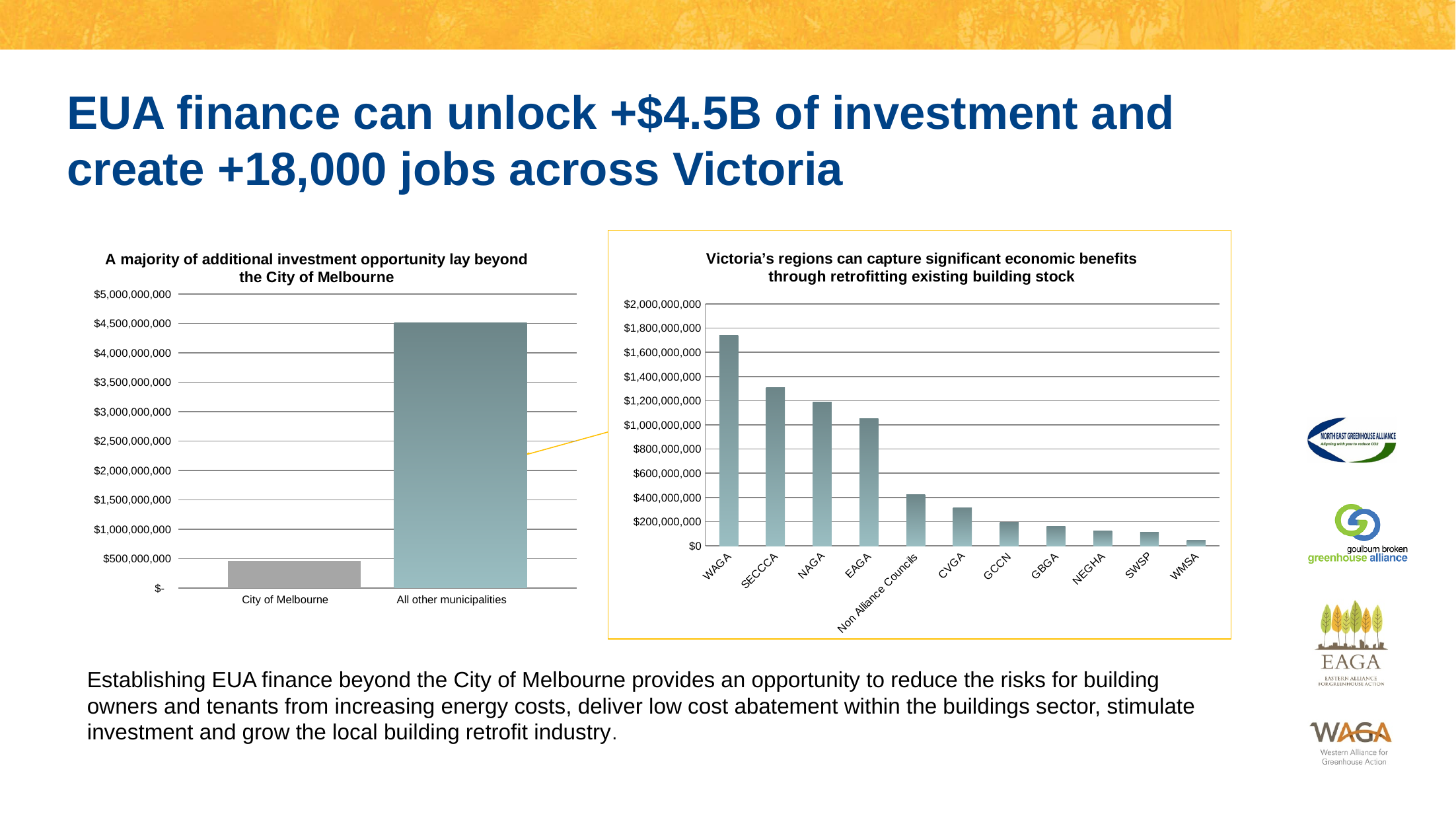
What kind of chart is the left chart titled 'A majority of additional investment opportunity lay beyond the City of Melbourne'? Bar chart In the right chart, do the values rise or fall moving from left to right along the x axis? Fall In the right chart, which region has the highest value? WAGA In the right chart, is the value for SECCCA greater or less than $1,200,000,000? greater In the left chart, which category has the higher value: City of Melbourne or All other municipalities? All other municipalities In the left chart, is the value for City of Melbourne greater or less than $500,000,000? less How many categories are shown in the right chart titled 'Victoria's regions can capture significant economic benefits through retrofitting existing building stock'? 11 In the right chart, which has the larger value: NAGA or EAGA? NAGA In the left chart, is the value for All other municipalities greater or less than $4,000,000,000? greater In the right chart, which region has the lowest value? WMSA